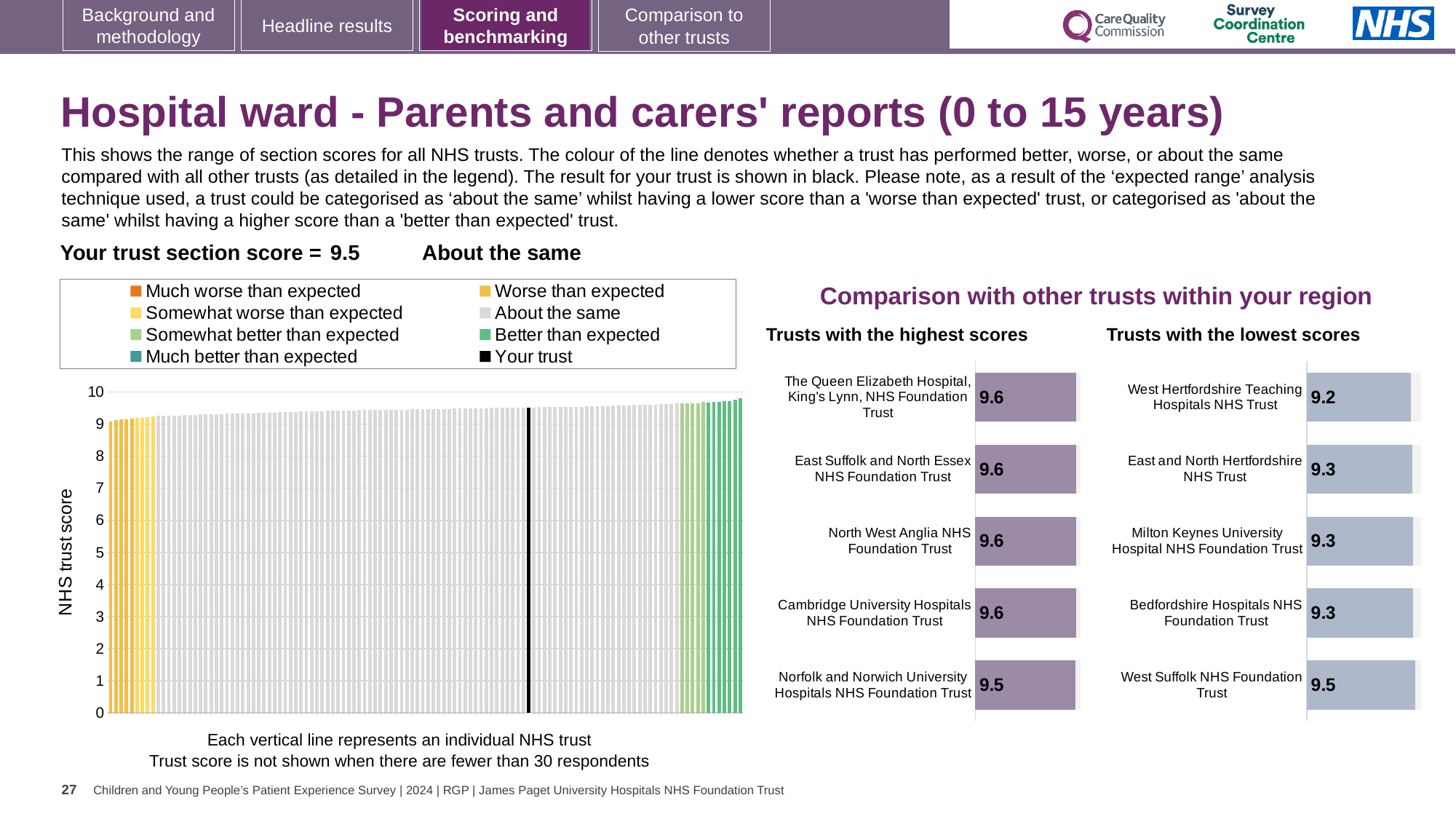
In the 'Trusts with the lowest scores' chart, what is the score for West Hertfordshire Teaching Hospitals NHS Trust? 9.2 In the 'Trusts with the lowest scores' chart, what is the score for West Suffolk NHS Foundation Trust? 9.5 In the 'Trusts with the highest scores' chart, what is the score for The Queen Elizabeth Hospital, King's Lynn, NHS Foundation Trust? 9.6 In the 'Trusts with the highest scores' chart, which has the larger score: The Queen Elizabeth Hospital, King's Lynn, NHS Foundation Trust or Norfolk and Norwich University Hospitals NHS Foundation Trust? The Queen Elizabeth Hospital, King's Lynn, NHS Foundation Trust How many trusts are listed in the 'Trusts with the highest scores' chart? 5 In the 'Trusts with the highest scores' chart, what is the score for Norfolk and Norwich University Hospitals NHS Foundation Trust? 9.5 What is the title of the section containing the two horizontal bar charts on the right of the slide? Comparison with other trusts within your region In the 'NHS trust score' chart, is the value for 'Your trust' (the black line) greater or less than 9? greater How many entries does the legend of the 'NHS trust score' chart list? 8 In the 'Trusts with the lowest scores' chart, which trust has the lowest score? West Hertfordshire Teaching Hospitals NHS Trust In the 'Trusts with the lowest scores' chart, what is the difference between the scores of West Suffolk NHS Foundation Trust and West Hertfordshire Teaching Hospitals NHS Trust? 0.3 What kind of chart is the large 'NHS trust score' chart on the left of the slide? Bar chart